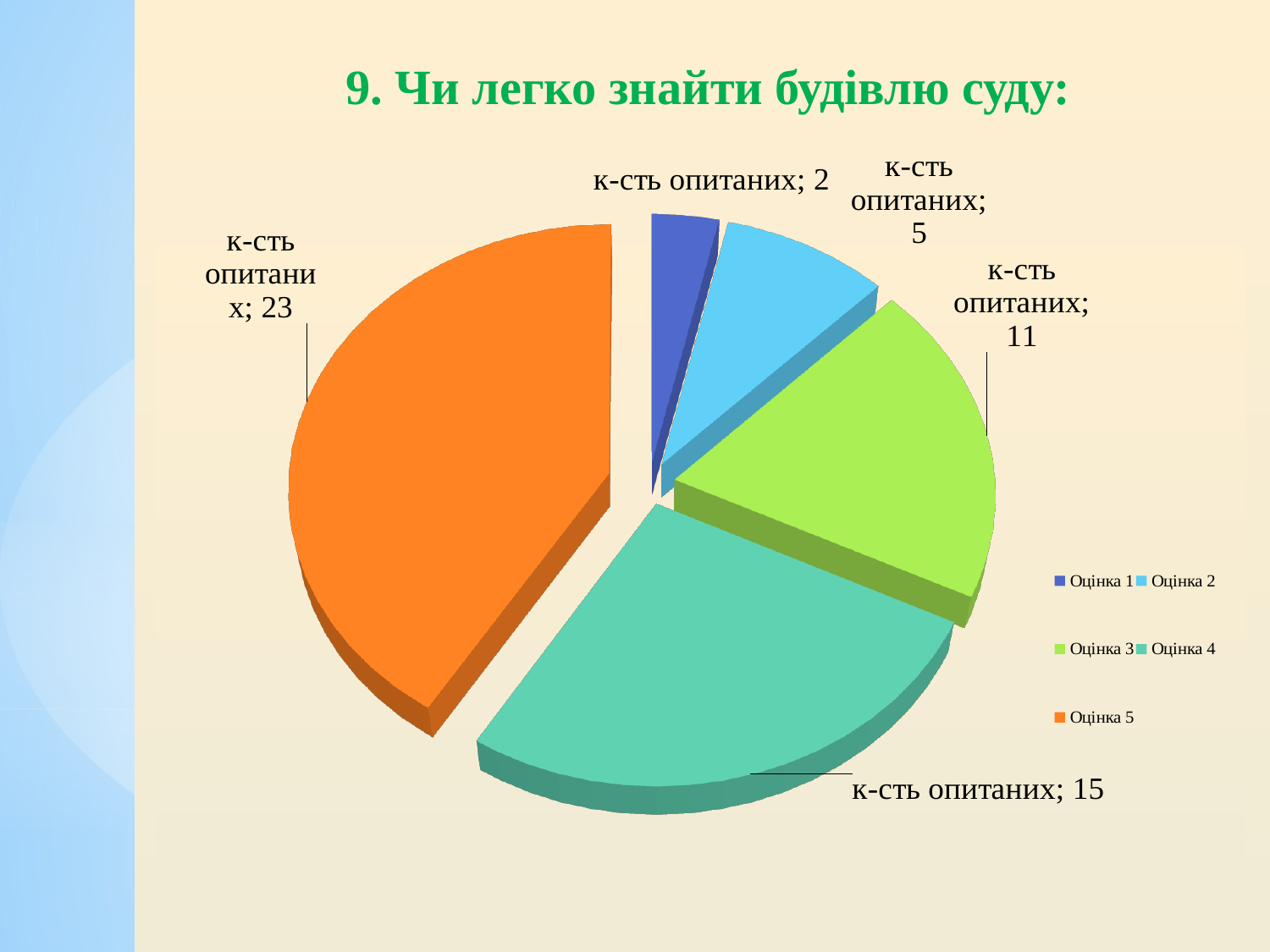
What is the total of all the values shown in the pie chart? 56 Which category has the smallest slice of the pie? Оцінка 1 What is the value (к-сть опитаних) for Оцінка 3? 11 What is the value (к-сть опитаних) for Оцінка 4? 15 How many slices does the pie chart have? 5 What is the title of the chart on the slide? 9. Чи легко знайти будівлю суду: What is the value (к-сть опитаних) for Оцінка 1? 2 Which is larger, the value for Оцінка 2 or the value for Оцінка 3? Оцінка 3 What is the difference between the values for Оцінка 5 and Оцінка 4? 8 What kind of chart is shown on the slide? pie chart Which category has the largest slice of the pie? Оцінка 5 What is the value (к-сть опитаних) for Оцінка 5? 23